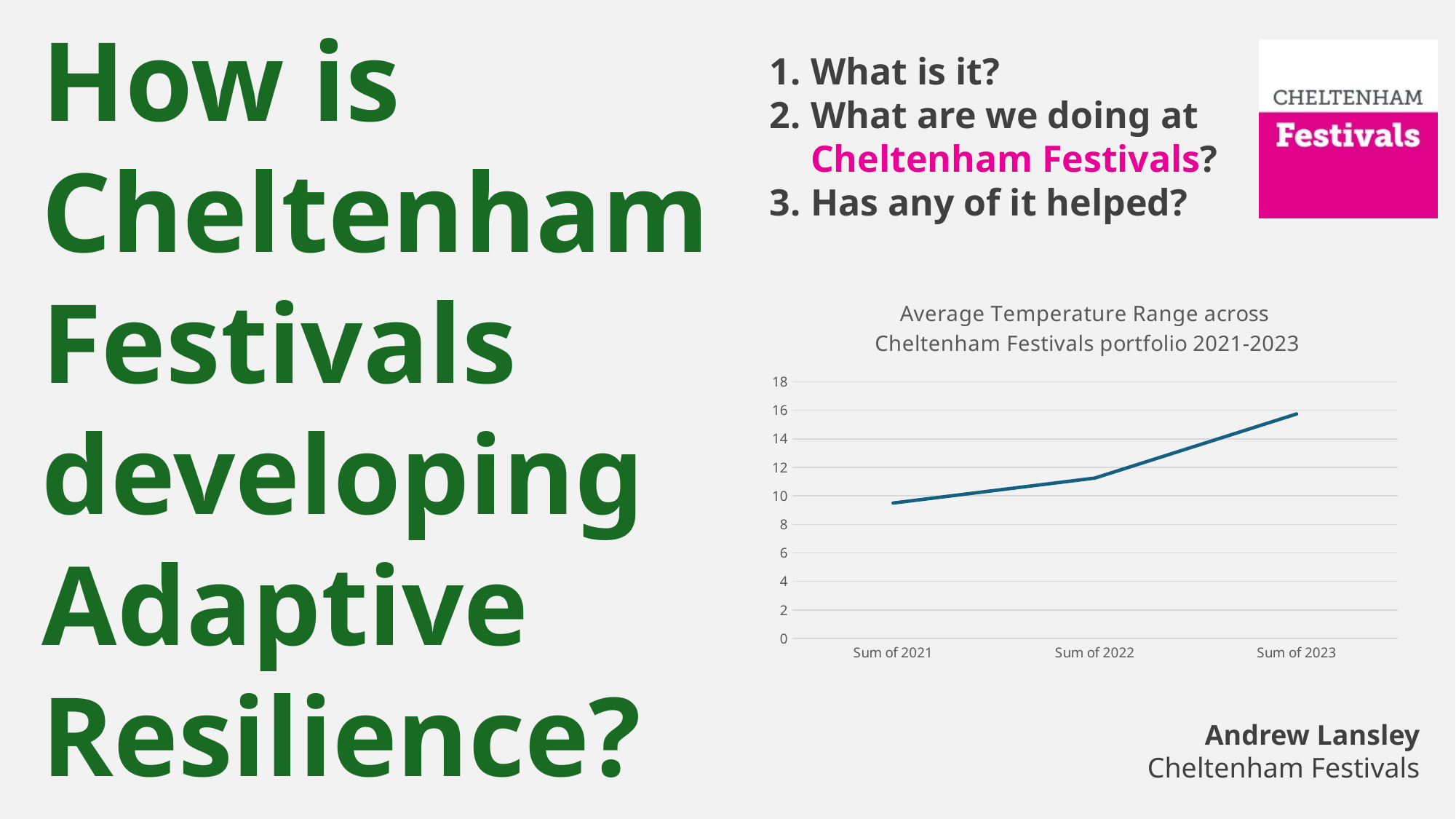
What is the highest value shown on the vertical axis? 18 Is the value for Sum of 2021 greater or less than 10? less What kind of chart is shown on the slide? line chart Is the value for Sum of 2023 greater or less than 14? greater Which category has the highest value? Sum of 2023 What is the title of the chart? Average Temperature Range across Cheltenham Festivals portfolio 2021-2023 Is the value for Sum of 2022 greater or less than 10? greater Which is larger, the value for Sum of 2022 or the value for Sum of 2023? Sum of 2023 Which is larger, the value for Sum of 2021 or the value for Sum of 2022? Sum of 2022 Which category has the lowest value? Sum of 2021 Do the values rise or fall from Sum of 2021 to Sum of 2023? rise How many data points are plotted on the line? 3